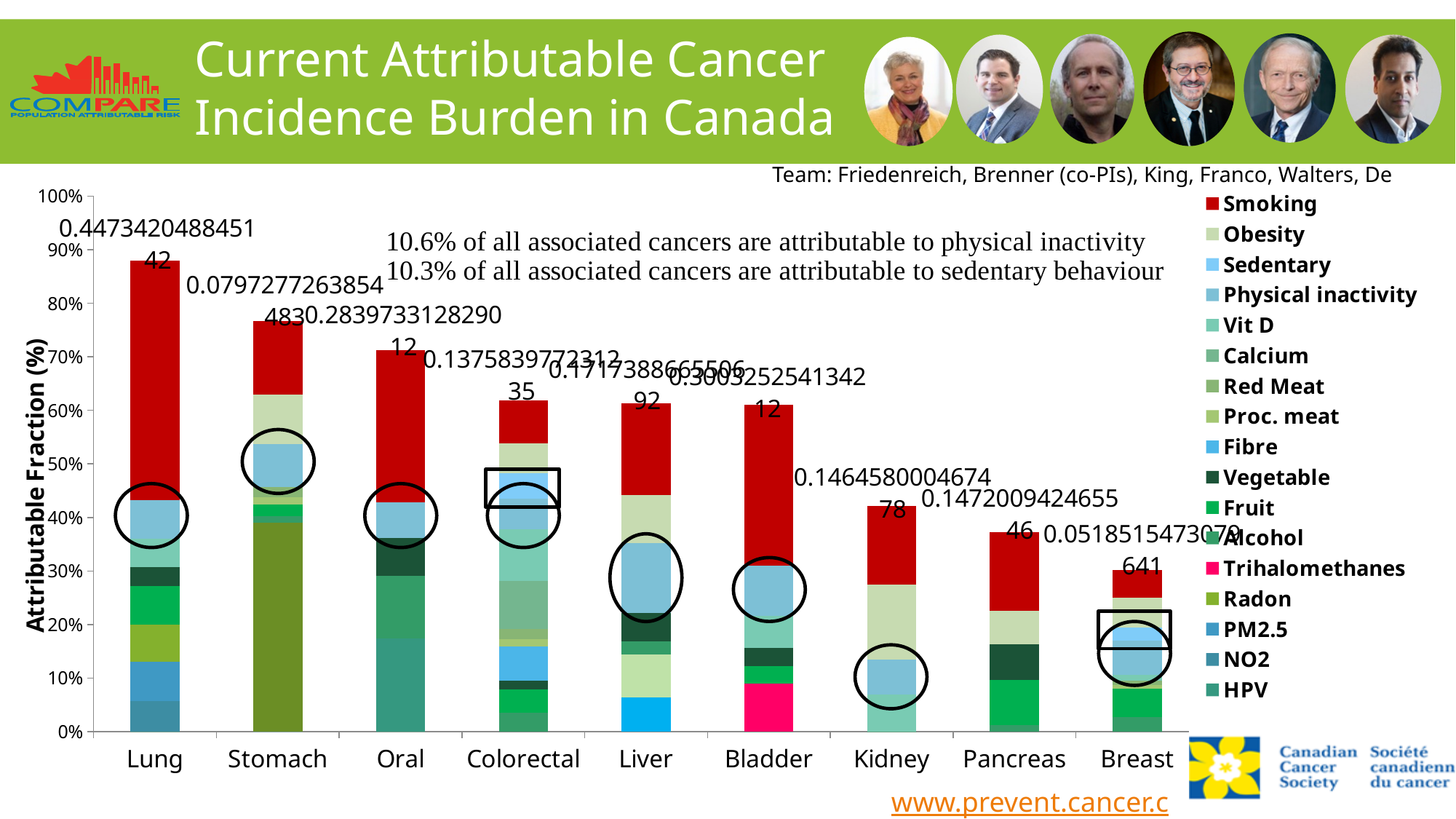
Is the total attributable fraction for Colorectal greater or less than 50%? greater How many risk factors does the chart's legend list? 17 Is the total attributable fraction for Breast greater or less than 40%? less Is the total attributable fraction for Lung greater or less than 80%? greater How many cancer types are shown along the x axis of the chart? 9 Which has a larger total attributable fraction, Stomach or Pancreas? Stomach What is the label on the chart's vertical axis? Attributable Fraction (%) Which cancer type has the highest total attributable fraction? Lung Which risk factor is shown in red in the chart's legend? Smoking Which cancer type has the lowest total attributable fraction? Breast What kind of chart is shown on the slide? Stacked bar chart